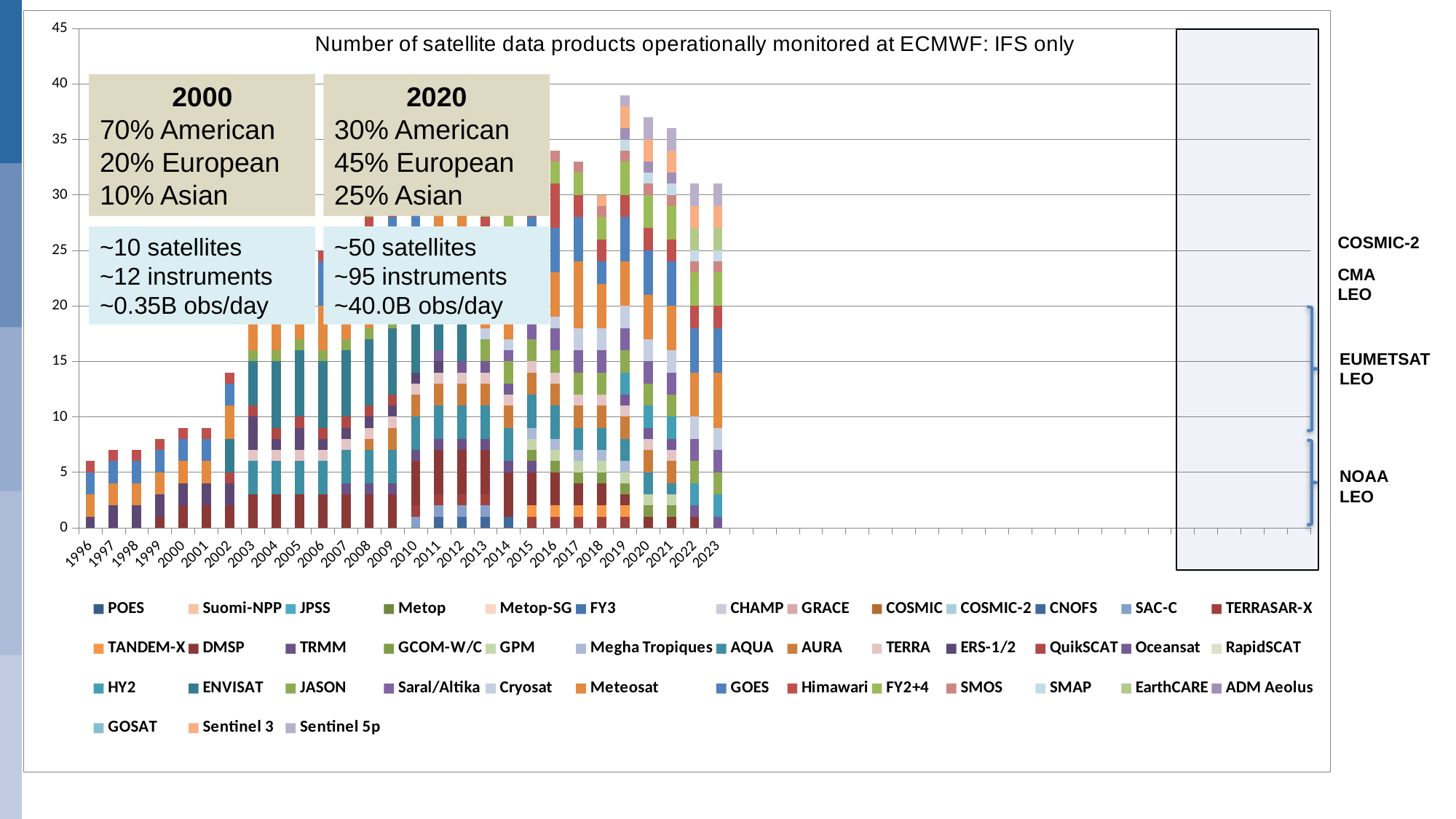
Is the total bar height for 2006 greater or less than 20? greater How many series does the chart's legend list? 42 Do the bar totals generally rise or fall from 1996 to 2019? rise Is the total bar height for 2016 greater or less than 30? greater Which bar is taller, 2006 or 2005? 2006 What kind of chart is shown on the slide? stacked bar chart Is the total bar height for 1996 greater or less than 10? less How many years are shown along the x axis of the chart? 28 Which year has the shortest bar in the chart? 1996 What is the title of the chart? Number of satellite data products operationally monitored at ECMWF: IFS only Which year has the tallest bar in the chart? 2019